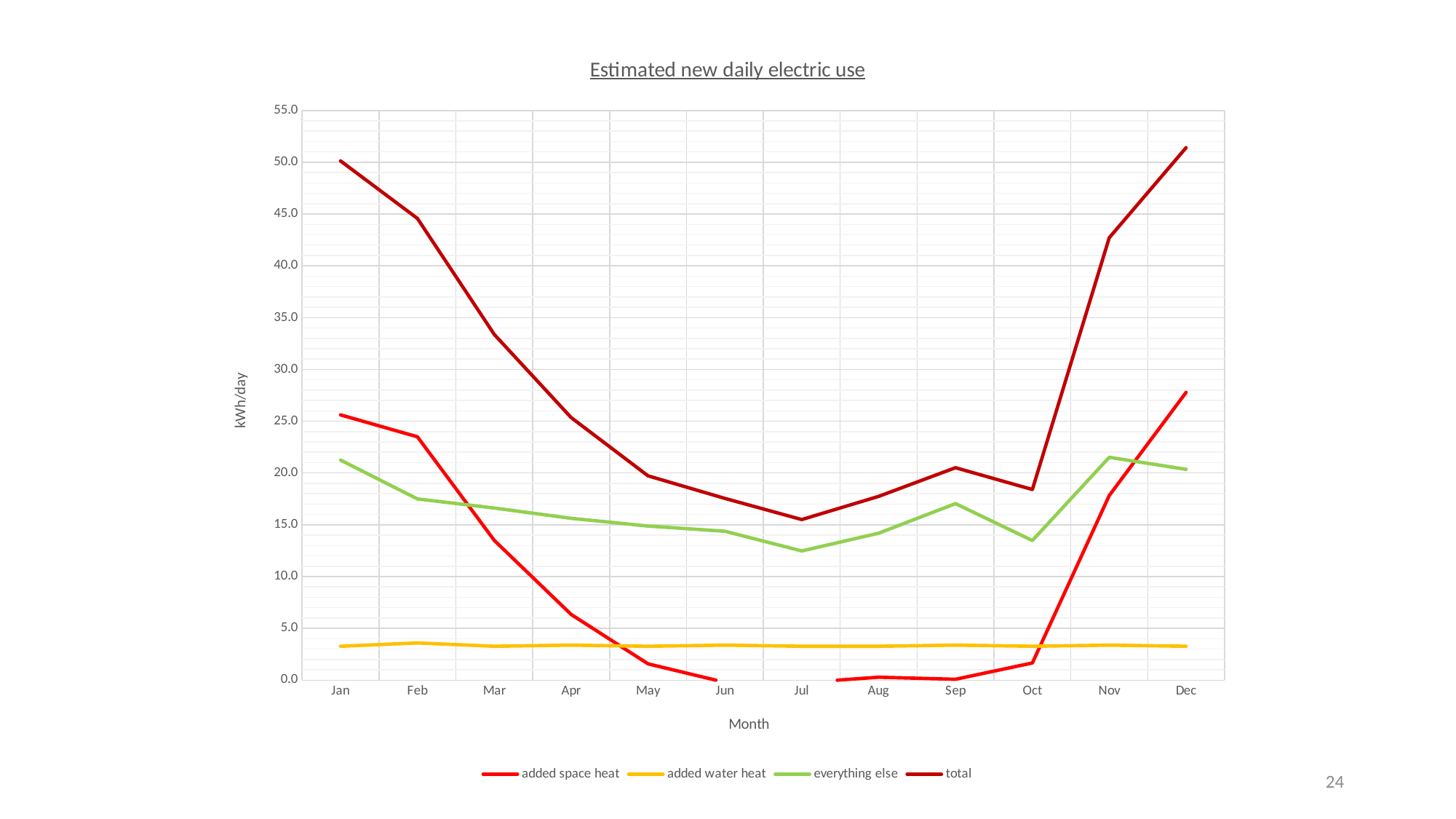
What kind of chart is shown on the slide? line chart What is the title of the chart? Estimated new daily electric use In Mar, which is larger: 'everything else' or 'added space heat'? everything else In which month is the 'everything else' series at its lowest? Jul In which month is the 'total' series at its lowest? Jul How many months are plotted along the x axis? 12 What is the label on the vertical axis? kWh/day Is the value for 'total' in Jan greater or less than 45.0? greater Is the value for 'added space heat' in Apr greater or less than 10.0? less Does the 'total' series rise or fall from Jan to Jul? fall In which month is the 'added space heat' series at its highest? Dec How many series does the legend list? 4